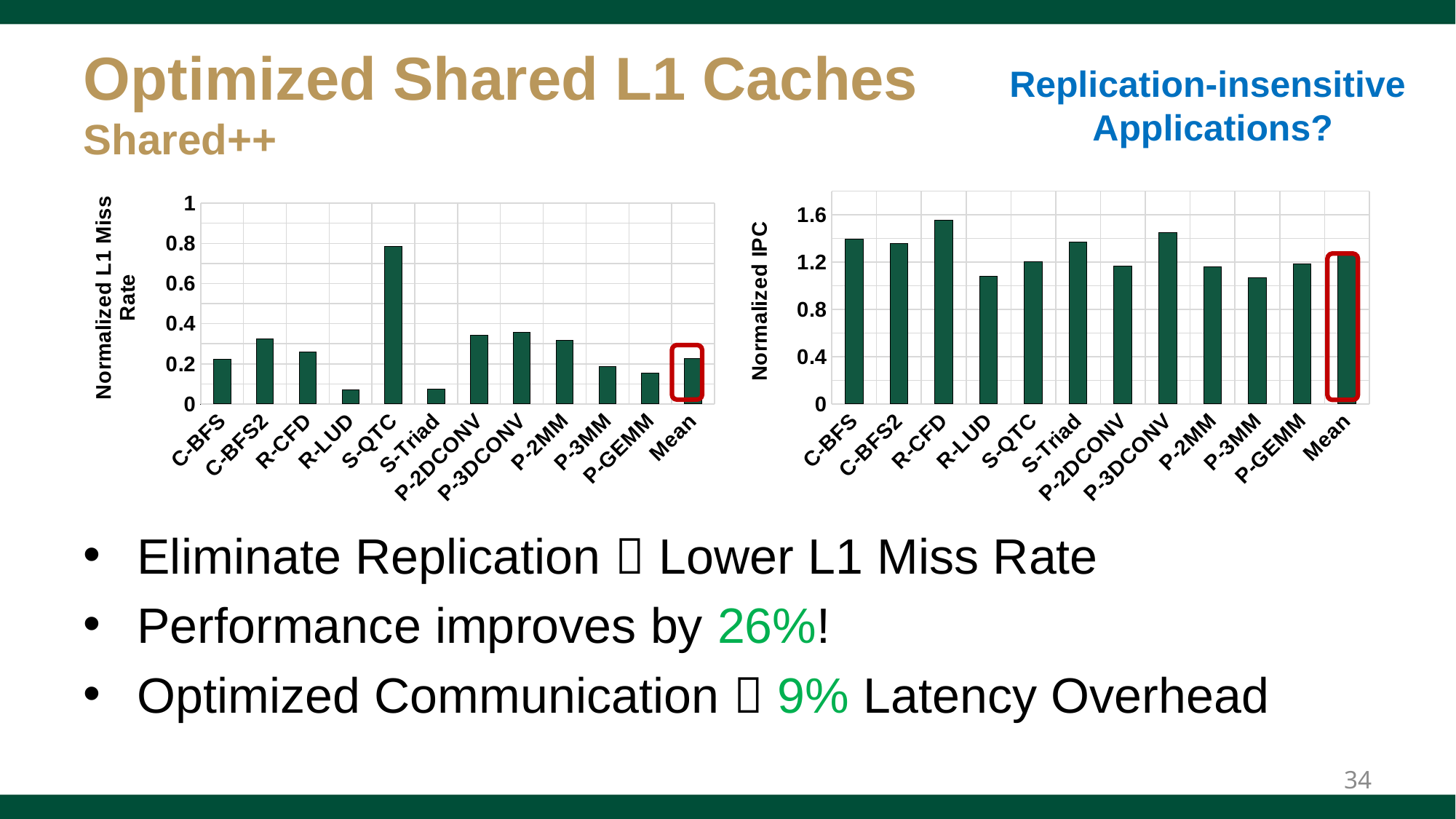
On the right chart (Normalized IPC), which category has the highest bar? R-CFD On the right chart (Normalized IPC), which category's bar is outlined with a red box? Mean On the right chart (Normalized IPC), is the value for R-LUD greater or less than 1.2? less On the left chart (Normalized L1 Miss Rate), is the value for S-QTC greater or less than 0.6? greater What kind of chart is the right chart (Normalized IPC)? Bar chart On the right chart (Normalized IPC), which is larger, the value for R-CFD or the value for R-LUD? R-CFD On the left chart (Normalized L1 Miss Rate), is the value for R-LUD greater or less than 0.2? less On the left chart (Normalized L1 Miss Rate), which is larger, the value for S-QTC or the value for C-BFS? S-QTC On the left chart (Normalized L1 Miss Rate), which category has the highest bar? S-QTC How many categories are shown on the x axis of the left chart (Normalized L1 Miss Rate)? 12 What is the y-axis label of the left chart? Normalized L1 Miss Rate